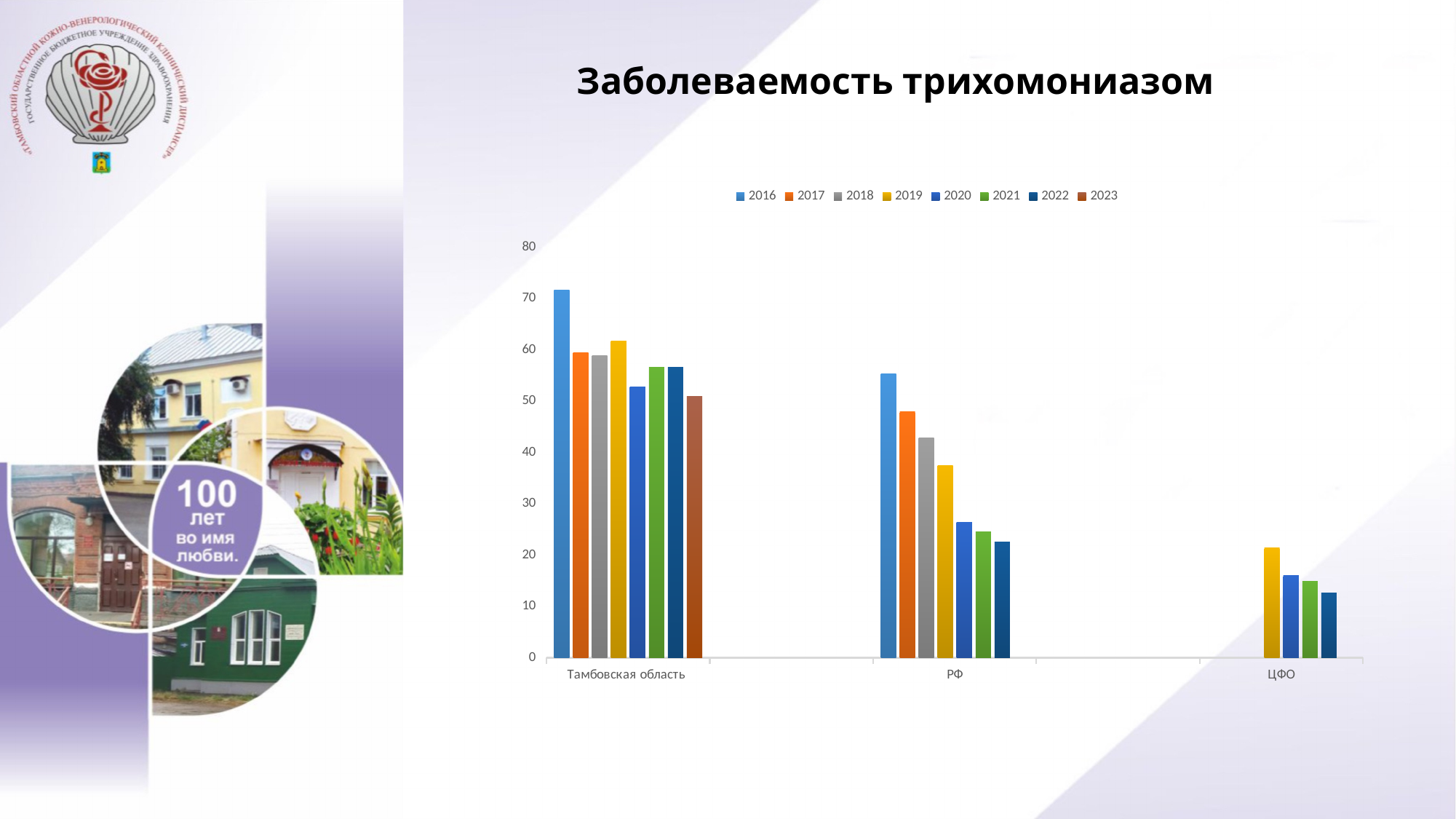
Is the value for ЦФО in 2022 greater or less than 10? greater Which year has the lowest value for Тамбовская область? 2023 What kind of chart is shown on the slide? bar chart How many categories are shown on the x axis? 3 Which year has the lowest value for ЦФО? 2022 Which is larger in 2019: the value for РФ or the value for ЦФО? РФ Which year has the highest value for Тамбовская область? 2016 Do the values for РФ rise or fall from 2016 to 2022? fall Is the value for Тамбовская область in 2016 greater or less than 60? greater Which year has the highest value for РФ? 2016 Is the value for РФ in 2022 greater or less than 30? less How many series does the legend list? 8